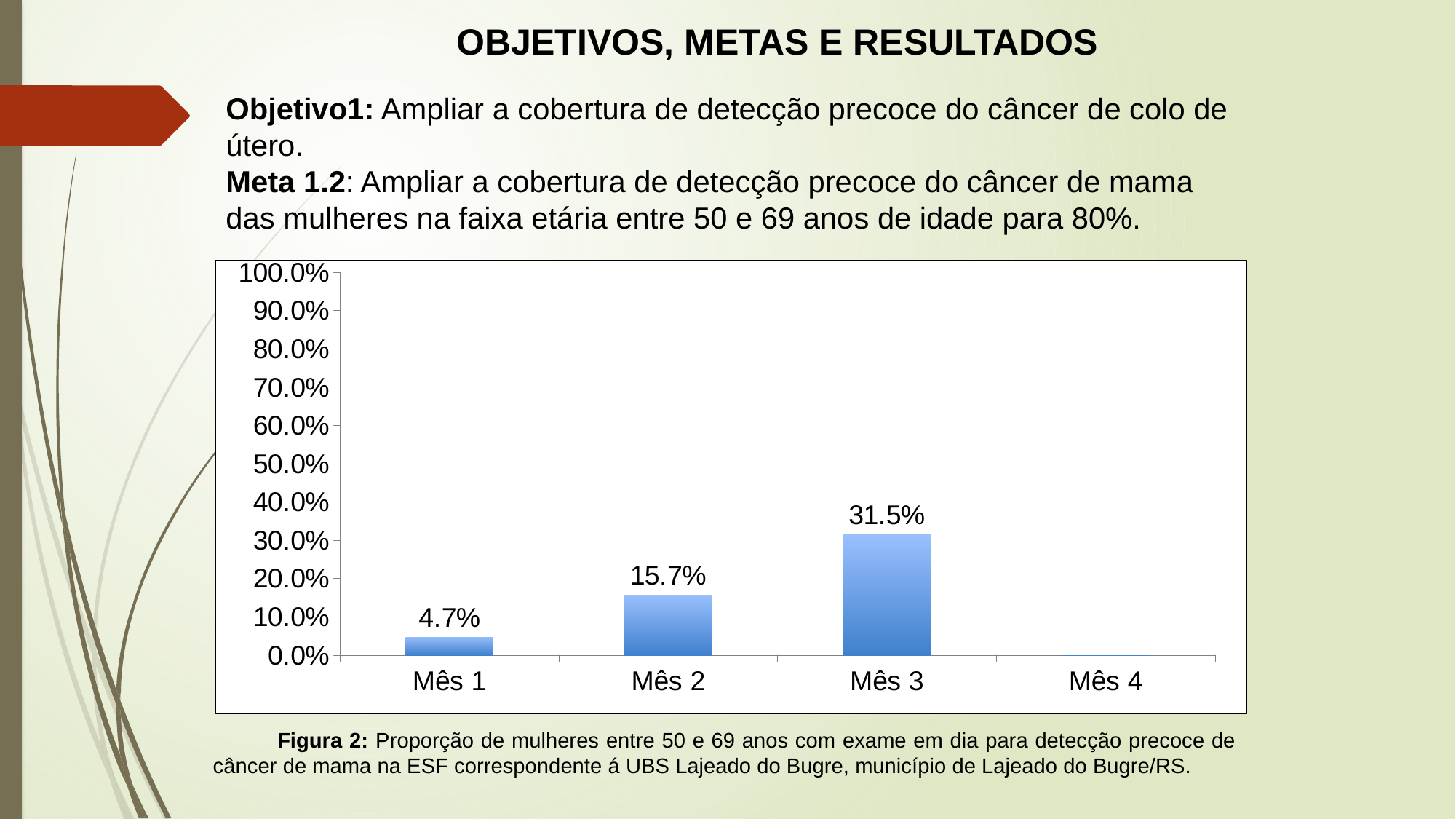
Do the values rise or fall from Mês 1 to Mês 3? rise How many months are shown on the x axis? 4 Which month has the lowest value? Mês 4 What is the value for Mês 3? 31.5% What is the value for Mês 2? 15.7% What is the value for Mês 1? 4.7% Which month has the highest value? Mês 3 Is the value for Mês 3 greater or less than 40%? less Which is larger, the value for Mês 2 or the value for Mês 1? Mês 2 What is the difference between the values for Mês 3 and Mês 2? 15.8% What kind of chart is shown on the slide? bar chart What is the difference between the values for Mês 2 and Mês 1? 11.0%